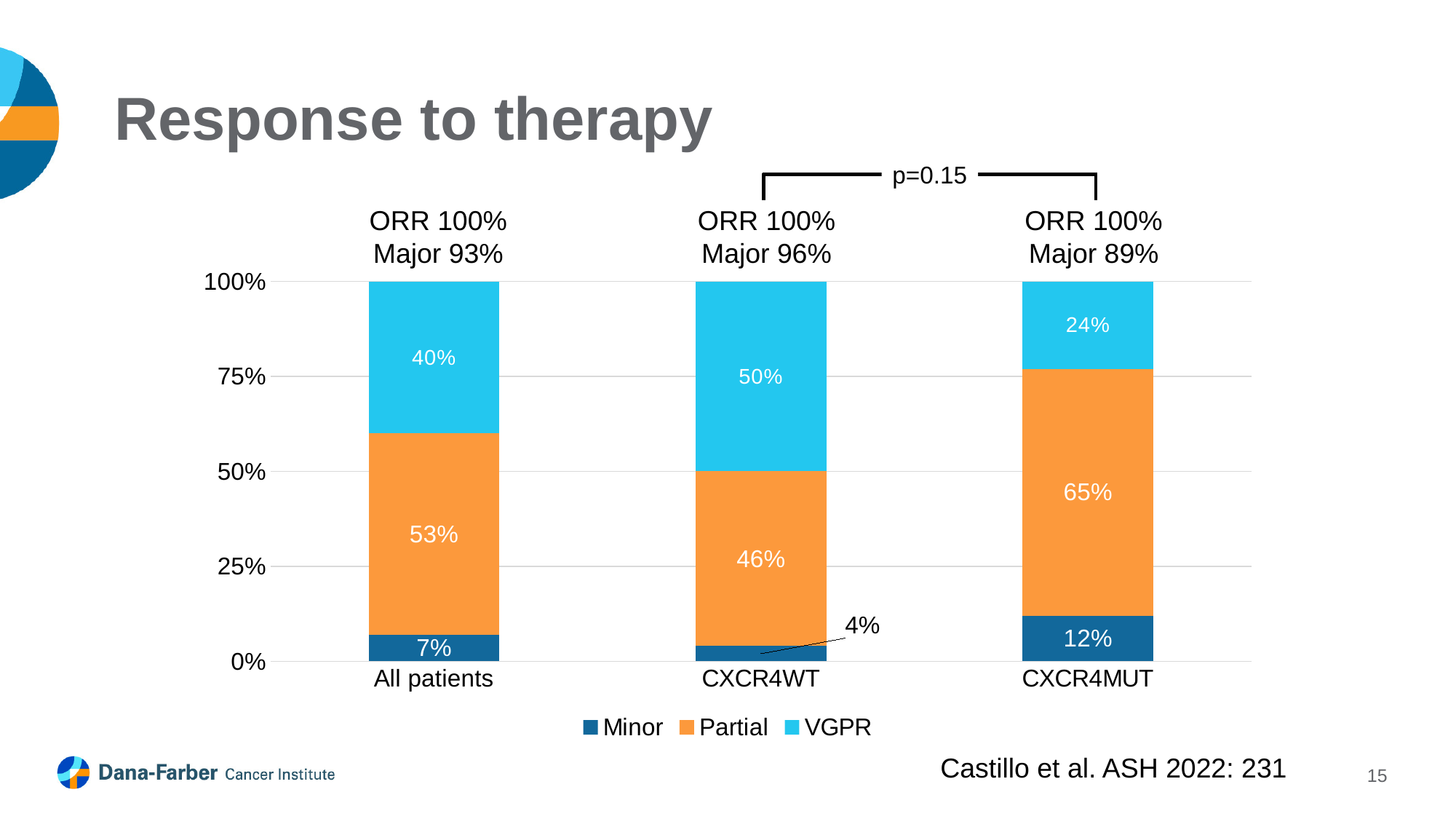
What kind of chart is shown on the slide? Stacked bar chart What p-value is shown between CXCR4WT and CXCR4MUT? p=0.15 What is the total of the stacked bar for CXCR4MUT? 101% Is the VGPR value larger for All patients or for CXCR4MUT? All patients What is the Minor value for All patients? 7% How many series does the legend list? 3 What is the difference between the Partial values for CXCR4MUT and CXCR4WT? 19% Which category has the highest VGPR value? CXCR4WT Which category has the lowest Minor value? CXCR4WT What is the VGPR value for CXCR4WT? 50% What is the Partial value for CXCR4MUT? 65% How many categories are shown on the x axis? 3